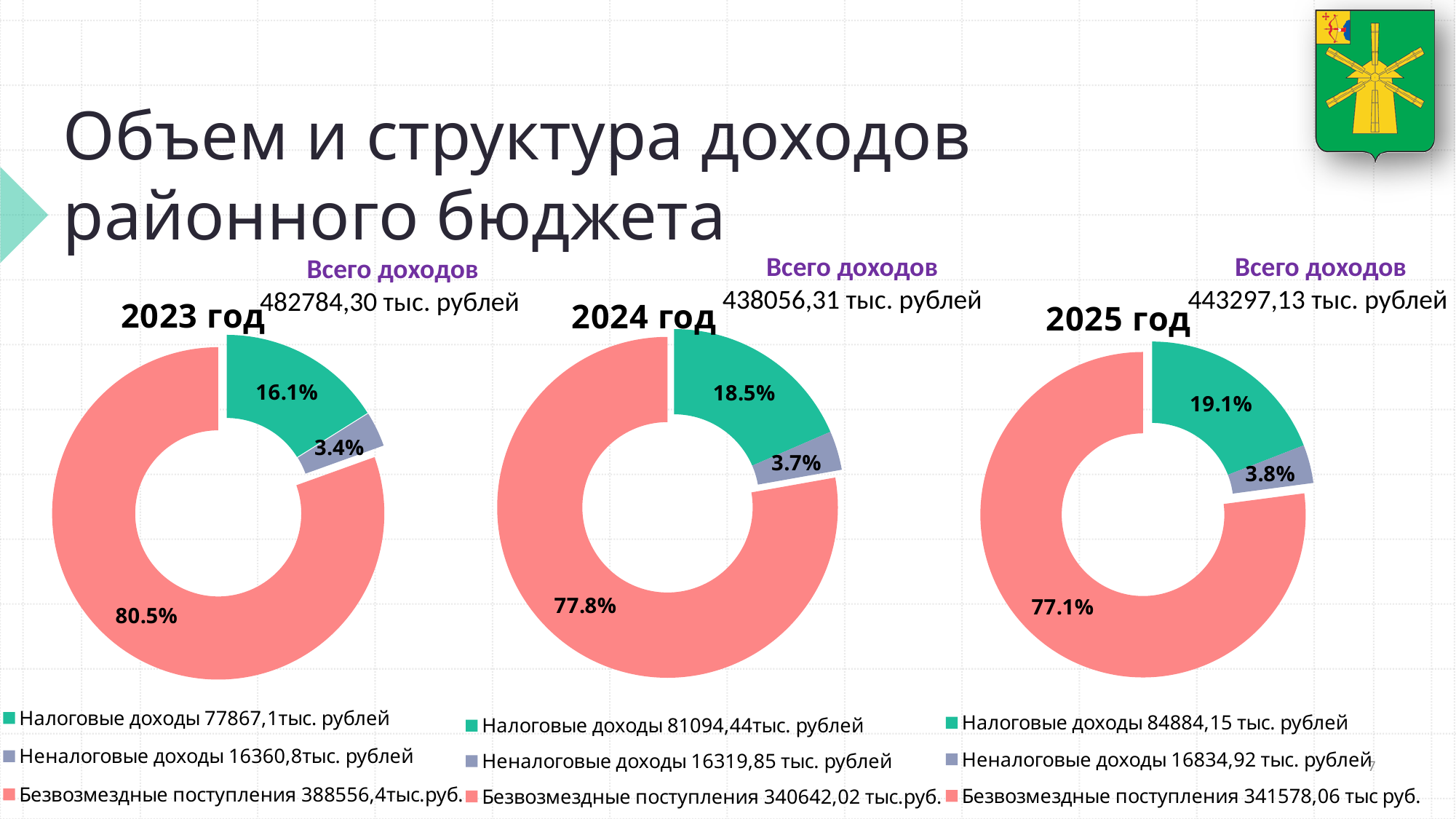
How many entries does the legend of the 2025 год chart list? 3 What is the difference between the share of Налоговые доходы in the 2025 год chart and in the 2023 год chart? 3.0% In the 2025 год chart, what share is shown for Неналоговые доходы? 3.8% What total income (Всего доходов) is shown above the 2025 год chart? 443297,13 тыс. рублей In the 2023 год chart, which category has the smallest share? Неналоговые доходы How many slices does the 2024 год chart have? 3 In the 2023 год chart, what share is shown for Безвозмездные поступления? 80.5% According to the legend of the 2024 год chart, what is the value of Налоговые доходы? 81094,44тыс. рублей In the 2024 год chart, which is larger: the share of Налоговые доходы or the share of Неналоговые доходы? Налоговые доходы What kind of chart is used for the 2023 год chart? Doughnut (pie) chart In the 2024 год chart, what share is shown for Налоговые доходы? 18.5% In the 2025 год chart, which category has the largest share? Безвозмездные поступления